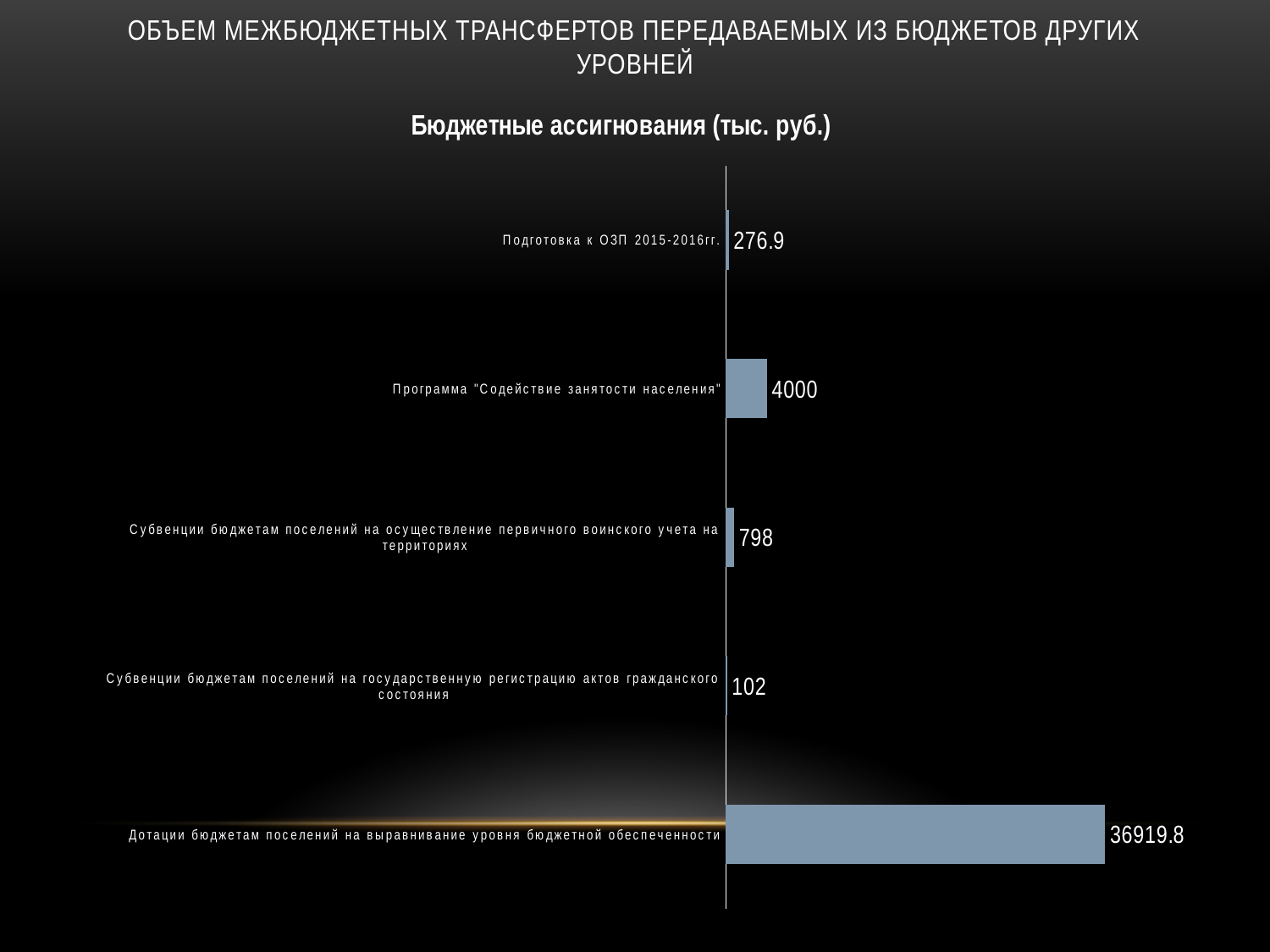
What is the difference between the value for "Программа "Содействие занятости населения"" and the value for "Субвенции бюджетам поселений на осуществление первичного воинского учета на территориях"? 3202 What is the value for "Программа "Содействие занятости населения""? 4000 What is the value for "Подготовка к ОЗП 2015-2016гг."? 276.9 What is the title of the chart? Бюджетные ассигнования (тыс. руб.) What is the value for "Субвенции бюджетам поселений на осуществление первичного воинского учета на территориях"? 798 What is the value for "Дотации бюджетам поселений на выравнивание уровня бюджетной обеспеченности"? 36919.8 What kind of chart is shown on the slide? Bar chart Which category has the lowest value? Субвенции бюджетам поселений на государственную регистрацию актов гражданского состояния How many categories are shown in the chart? 5 What is the difference between the value for "Подготовка к ОЗП 2015-2016гг." and the value for "Субвенции бюджетам поселений на государственную регистрацию актов гражданского состояния"? 174.9 Which category has the highest value? Дотации бюджетам поселений на выравнивание уровня бюджетной обеспеченности Which is larger: the value for "Подготовка к ОЗП 2015-2016гг." or the value for "Субвенции бюджетам поселений на осуществление первичного воинского учета на территориях"? Субвенции бюджетам поселений на осуществление первичного воинского учета на территориях